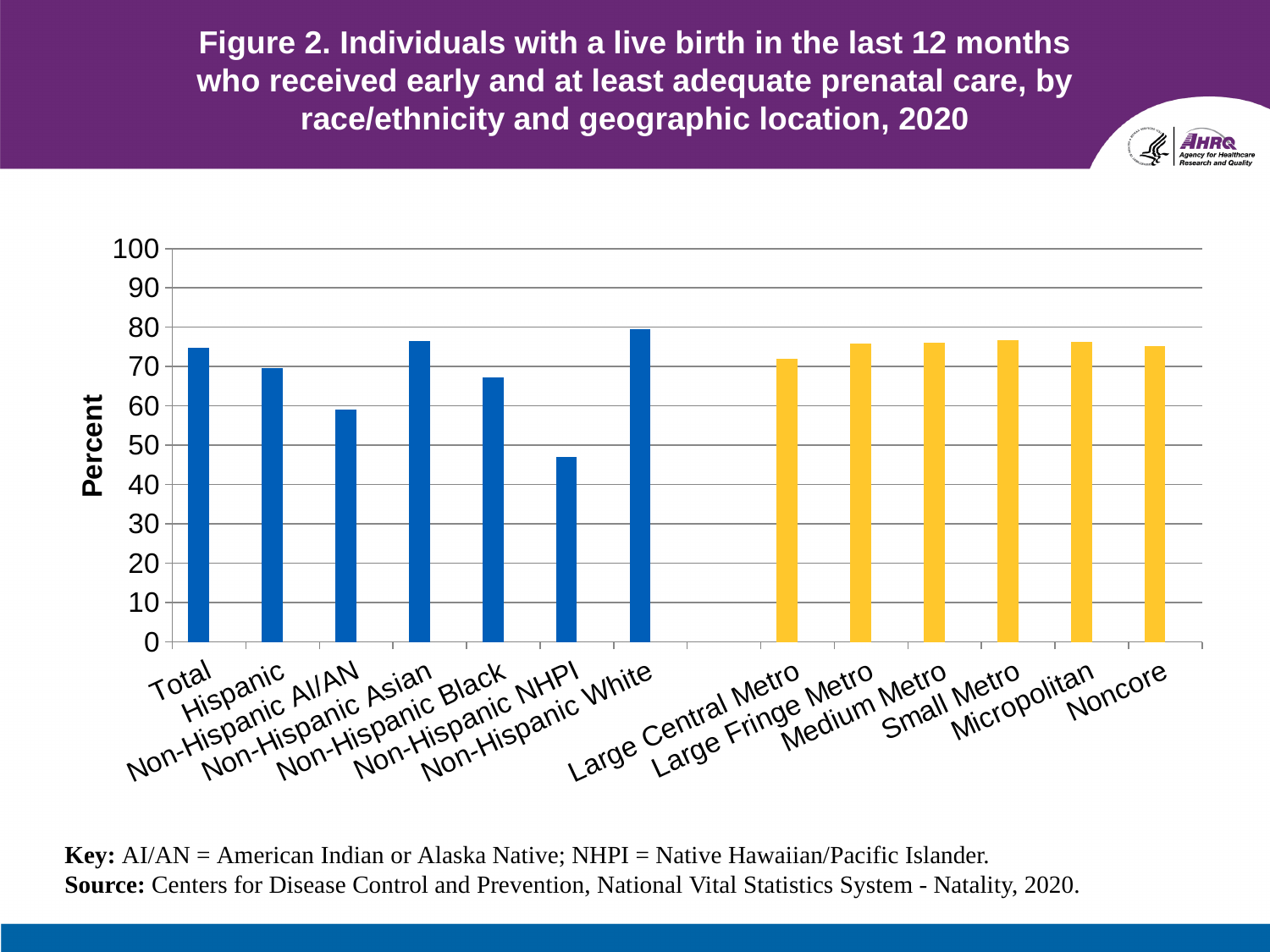
What colour are the bars for the geographic location categories? Yellow Which is larger, the value for Non-Hispanic Asian or the value for Non-Hispanic Black? Non-Hispanic Asian What kind of chart is shown on the slide? Bar chart Is the value for Non-Hispanic NHPI greater or less than 50? less What is the label on the vertical axis? Percent Which category has the lowest value? Non-Hispanic NHPI Is the value for Non-Hispanic Black greater or less than 70? less Is the value for Non-Hispanic AI/AN greater or less than 50? greater How many categories are plotted on the x axis? 13 Which is larger, the value for Large Central Metro or the value for Small Metro? Small Metro Among the race/ethnicity groups, which category has the highest value? Non-Hispanic White